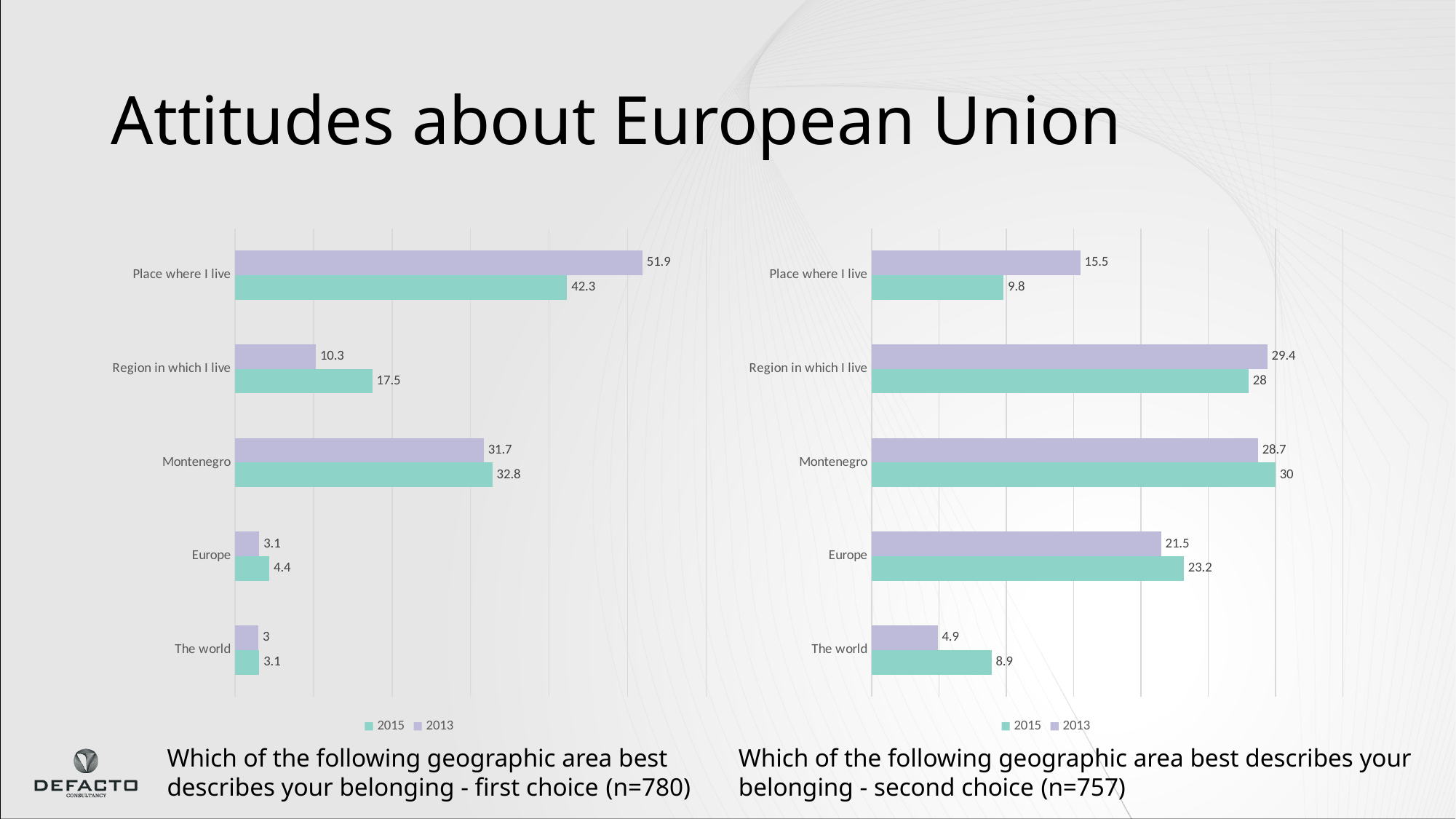
In the first-choice chart on the left, what is the 2013 value for Place where I live? 51.9 How many categories are shown in the first-choice chart on the left? 5 In the second-choice chart on the right, what is the difference between the 2015 and 2013 values for The world? 4 How many series does the legend of the second-choice chart on the right list? 2 In the first-choice chart on the left, what is the 2015 value for Region in which I live? 17.5 In the second-choice chart on the right, which is larger for Place where I live, the 2013 value or the 2015 value? 2013 In the first-choice chart on the left, which category has the highest 2015 value? Place where I live What type of chart is the first-choice chart on the left? Bar chart In the second-choice chart on the right, what is the 2013 value for Europe? 21.5 In the first-choice chart on the left, what is the difference between the 2013 and 2015 values for Place where I live? 9.6 In the second-choice chart on the right, what is the 2015 value for Montenegro? 30 In the second-choice chart on the right, which category has the lowest 2013 value? The world